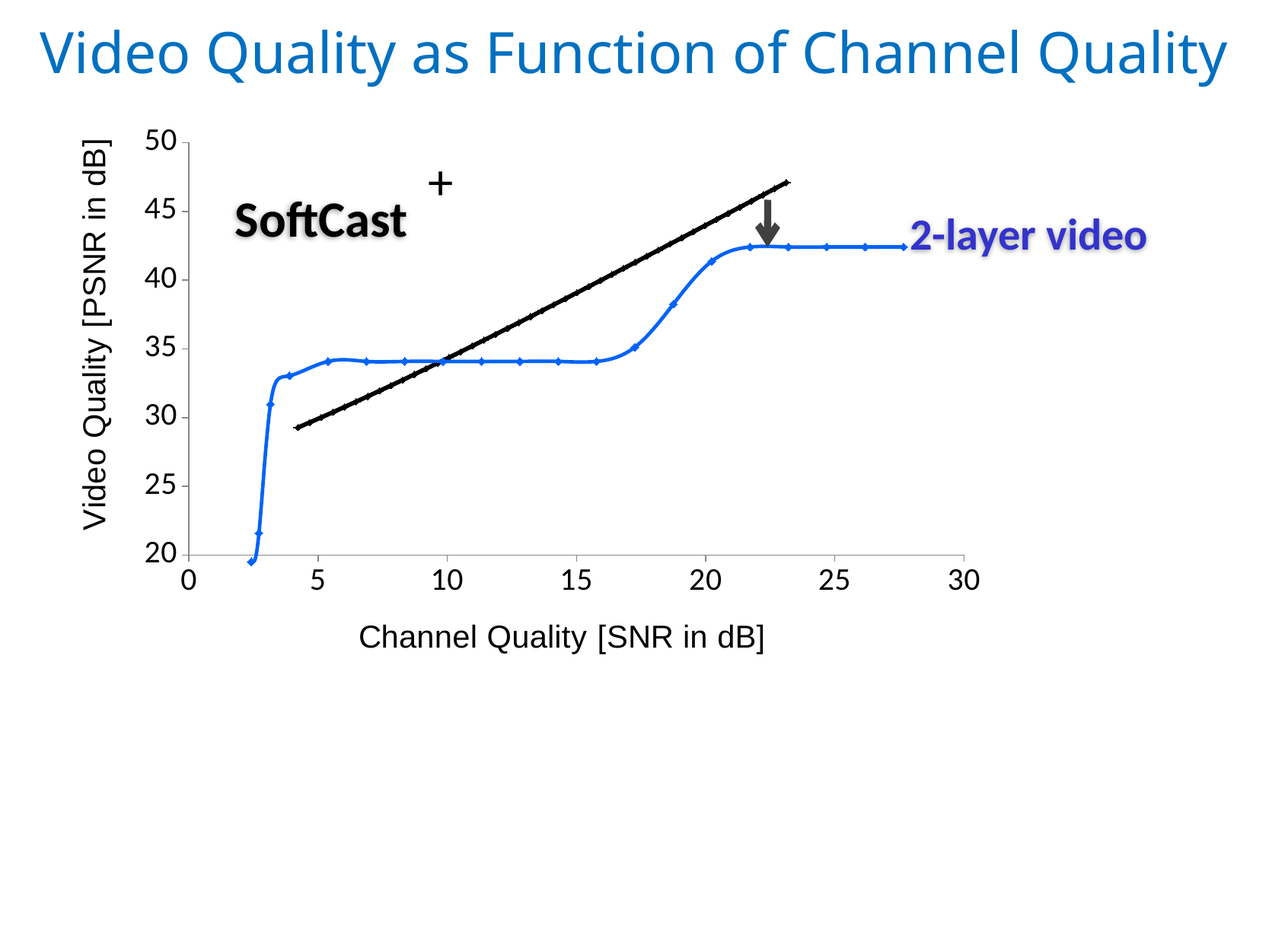
Is the video quality of 2-layer video at a channel quality of 25 dB greater or less than 40? greater How many data series are plotted on the chart? 2 Is the video quality of SoftCast at a channel quality of 15 dB greater or less than 35? greater Which series reaches the highest video quality on the chart? SoftCast What kind of chart is shown on the slide? line chart What is the label of the x axis? Channel Quality [SNR in dB] Does the SoftCast line rise or fall as channel quality increases? rise Is the video quality of 2-layer video at a channel quality of 25 dB greater or less than 45? less What is the title of the chart on the slide? Video Quality as Function of Channel Quality At a channel quality of 15 dB, which series has the higher video quality, SoftCast or 2-layer video? SoftCast At a channel quality of 5 dB, which series has the higher video quality, SoftCast or 2-layer video? 2-layer video